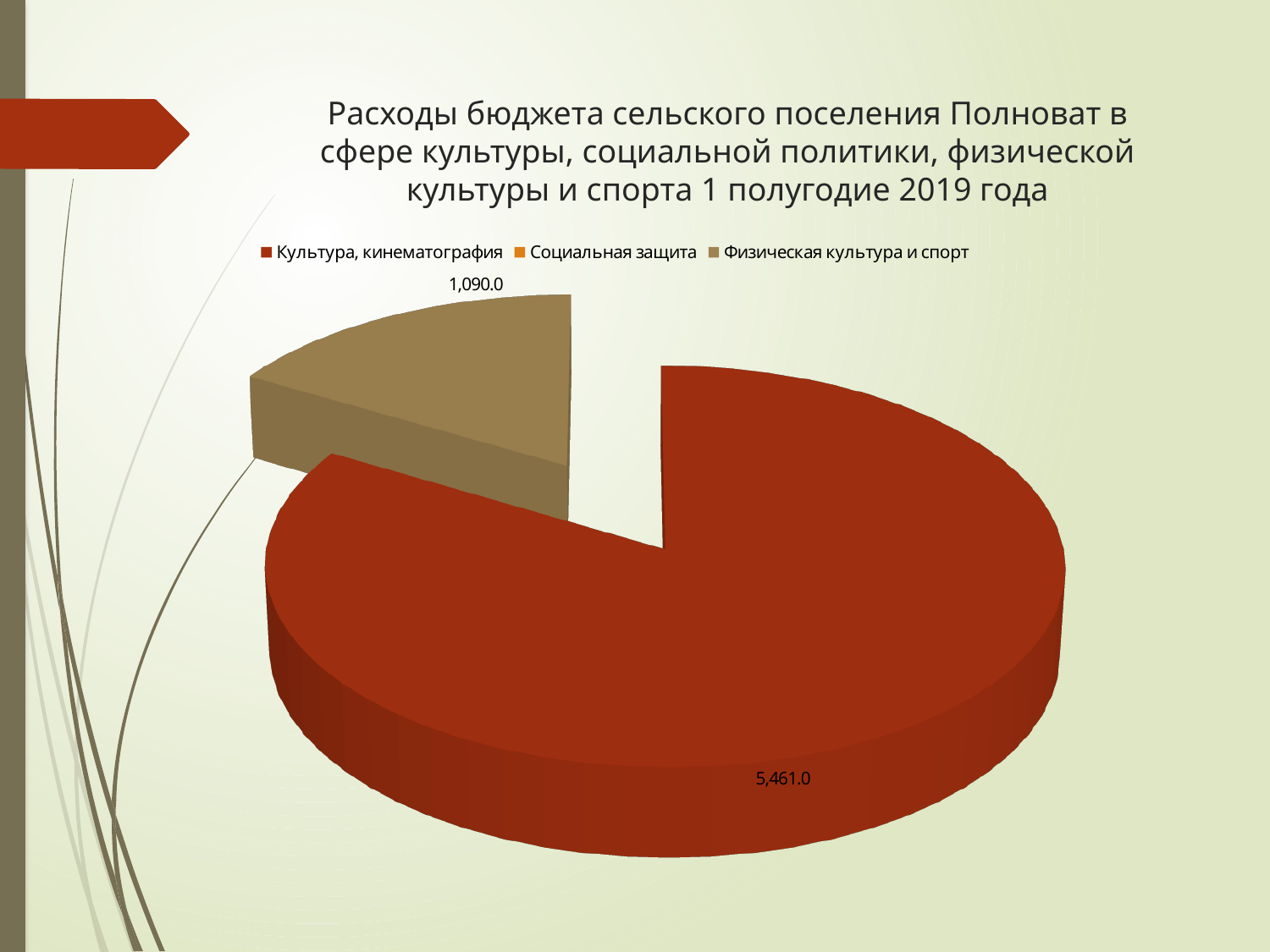
Which is larger: Культура, кинематография or Физическая культура и спорт? Культура, кинематография Which category has the largest slice of the pie? Культура, кинематография What is the value shown for Физическая культура и спорт? 1,090.0 Which legend entry is shown in orange? Социальная защита What kind of chart is shown on the slide? pie chart What is the difference between the values for Культура, кинематография and Физическая культура и спорт? 4,371.0 What colour is the slice for Культура, кинематография? red What is the value shown for Культура, кинематография? 5,461.0 How many entries does the legend list? 3